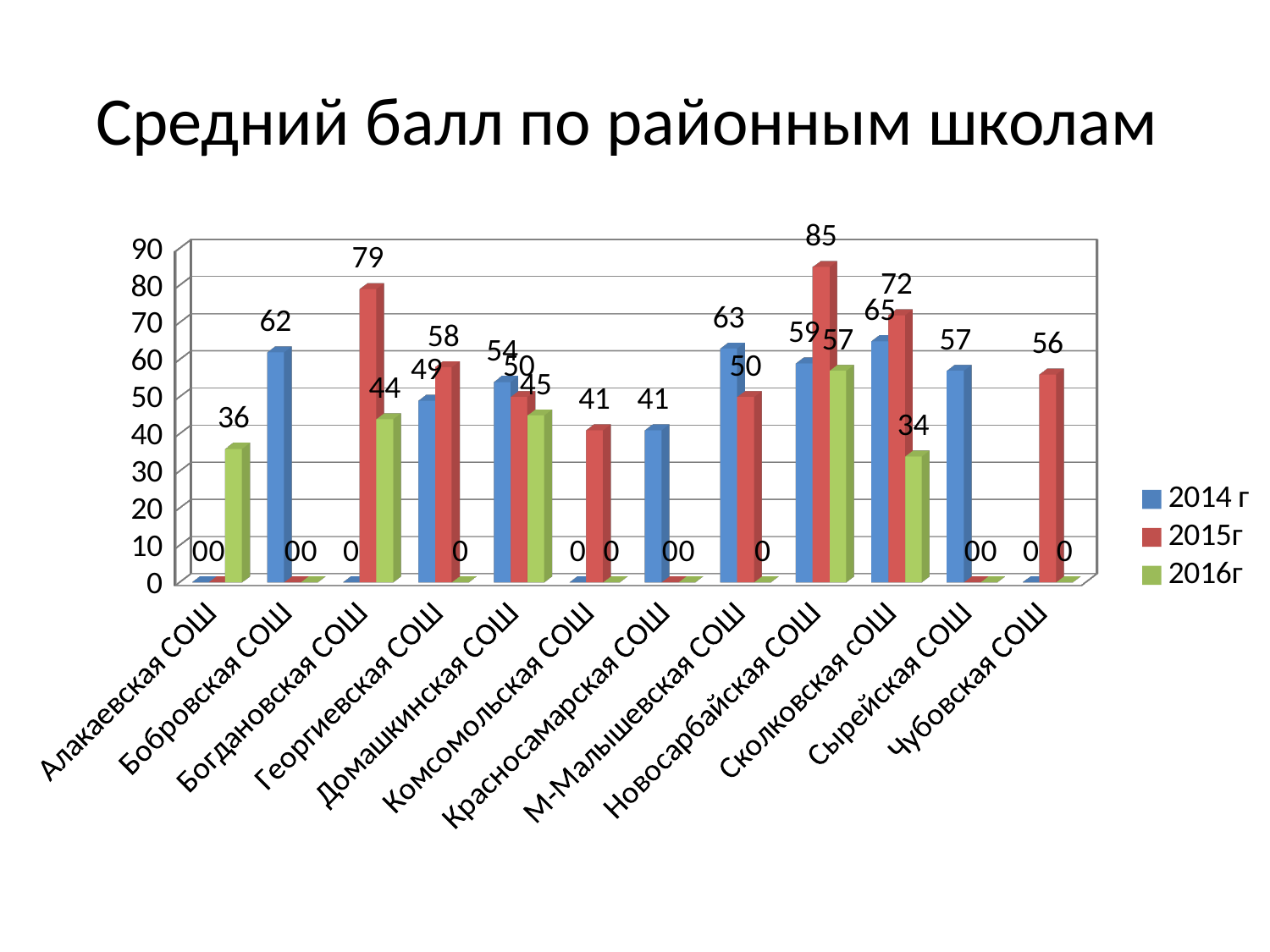
How many series does the legend list? 3 Which is larger for Домашкинская СОШ: the 2014 г value or the 2016г value? 2014 г What is the difference between the 2015г value for Богдановская СОШ and the 2015г value for Георгиевская СОШ? 21 What is the title of the chart? Средний балл по районным школам What is the value for Сырейская СОШ in the 2014 г series? 57 What is the value for Богдановская СОШ in the 2016г series? 44 What is the difference between the 2015г and 2014 г values for Сколковская СОШ? 7 How many schools are shown on the x axis? 12 Which school has the highest value in the 2015г series? Новосарбайская СОШ What is the value for Новосарбайская СОШ in the 2015г series? 85 Which school has the highest value in the 2014 г series? Сколковская СОШ What type of chart is shown on the slide? Bar chart